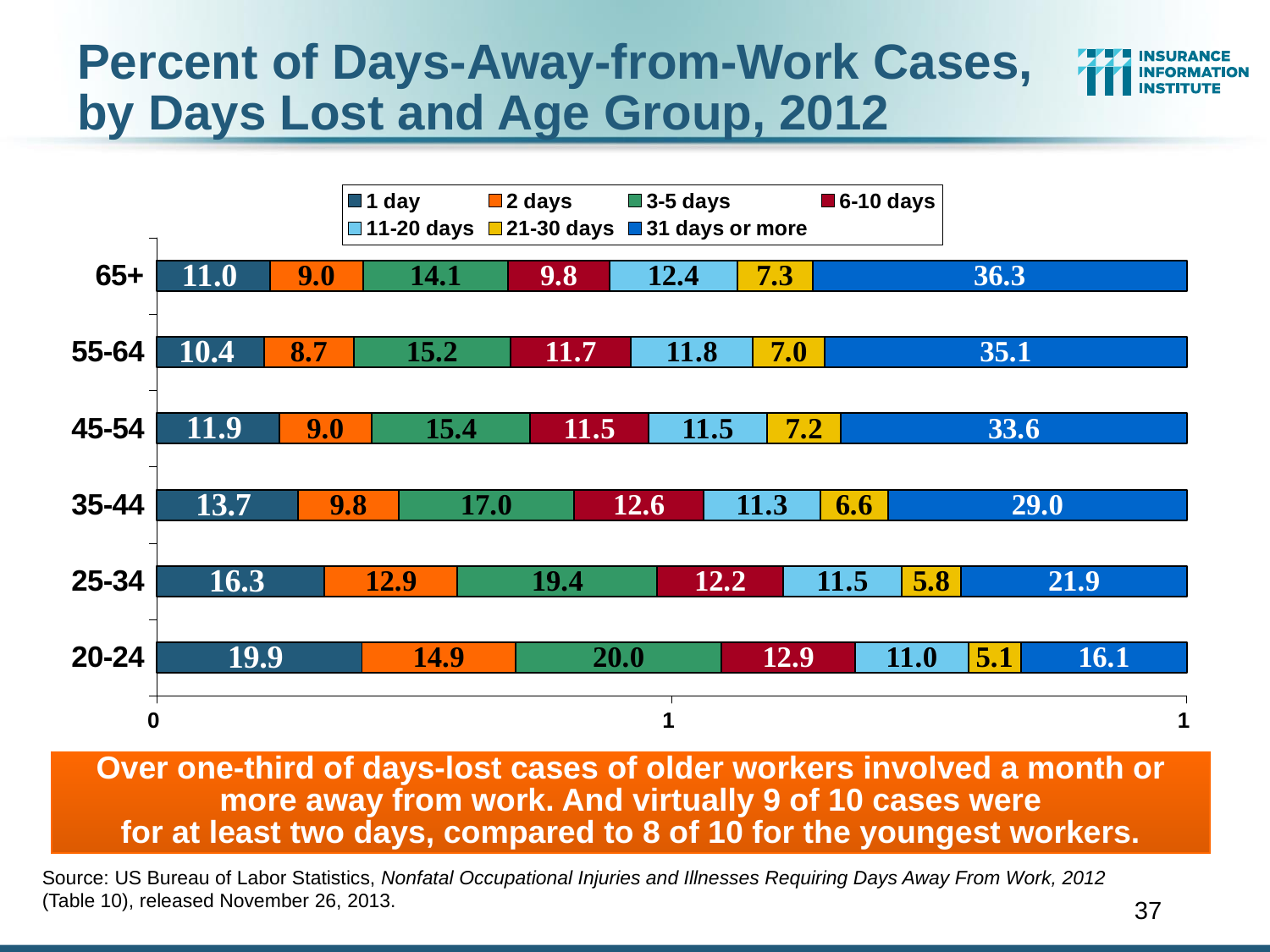
What is the value for '1 day' for the 20-24 age group? 19.9 What kind of chart is shown on the slide? Stacked bar chart Which age group has the highest value for '31 days or more'? 65+ How many series does the legend list? 7 What is the value for '21-30 days' for the 25-34 age group? 5.8 What is the difference between the '31 days or more' values for the 65+ and 20-24 age groups? 20.2 Which is larger: the '2 days' value for 20-24 or the '2 days' value for 65+? 20-24 Does the '31 days or more' share rise or fall as the age group gets older, from 20-24 to 65+? Rises What is the value for '3-5 days' for the 35-44 age group? 17.0 What is the value for '31 days or more' for the 65+ age group? 36.3 How many age groups are shown on the chart? 6 Which age group has the lowest value for '1 day'? 55-64